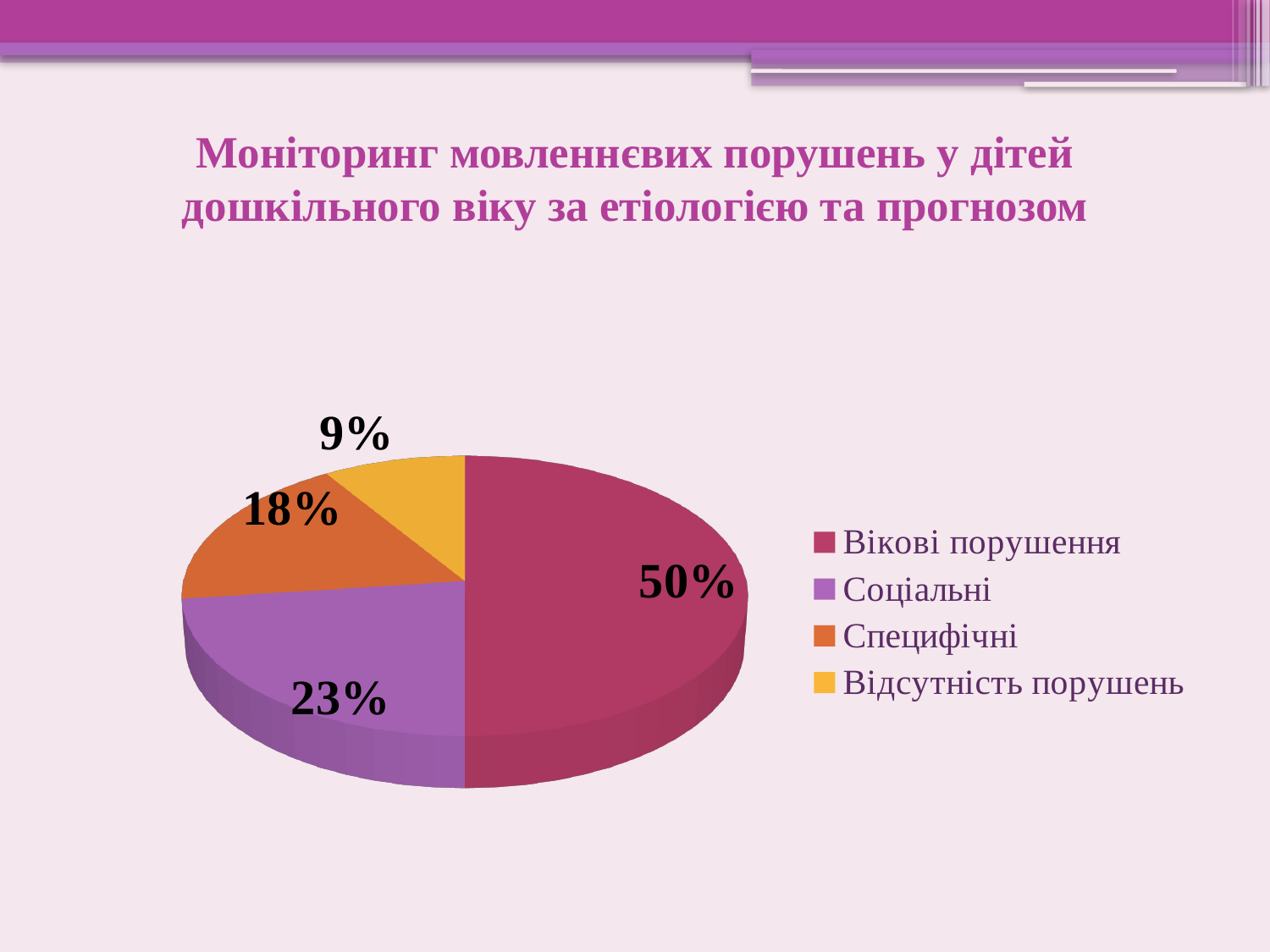
What is the value shown for Специфічні? 18% What colour is the slice for Відсутність порушень? Yellow What is the difference between the values for Вікові порушення and Соціальні? 27% Which category has the largest slice of the pie? Вікові порушення What share of the pie does Вікові порушення have? 50% How many categories does the pie chart show? 4 What is the value shown for Відсутність порушень? 9% What is the value shown for Соціальні? 23% What is the difference between the values for Специфічні and Відсутність порушень? 9% Which is larger, the slice for Соціальні or the slice for Специфічні? Соціальні Which category has the smallest slice of the pie? Відсутність порушень What kind of chart is shown on the slide? Pie chart